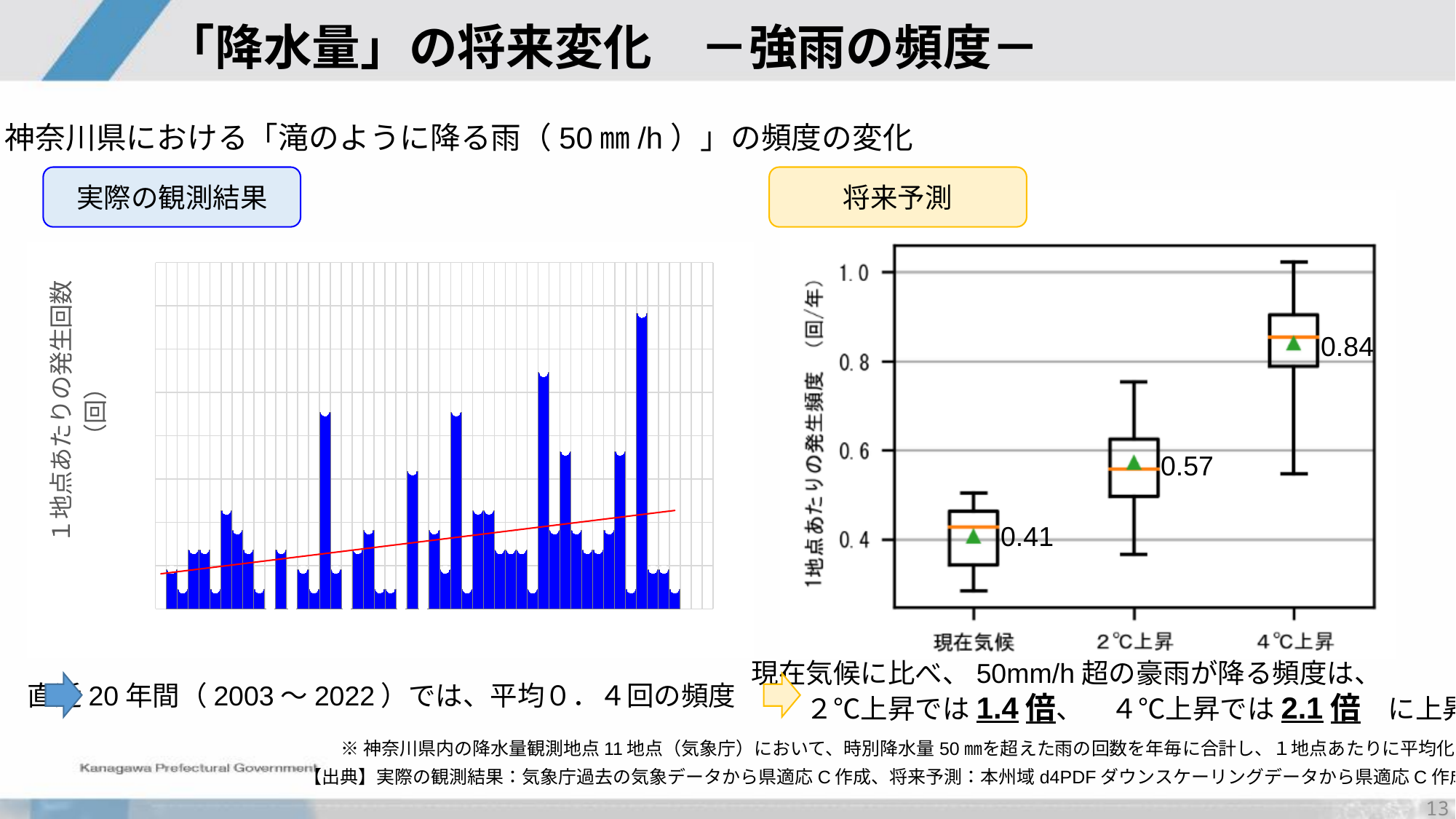
In the 将来予測 chart on the right, is the labelled value for 現在気候 greater or less than 0.6? less In the 将来予測 chart on the right, which is larger, the labelled value for 2℃上昇 or for 4℃上昇? 4℃上昇 How many categories are shown on the x axis of the 将来予測 chart on the right? 3 In the 将来予測 chart on the right, what is the labelled value for 現在気候? 0.41 In the 将来予測 chart on the right, what is the difference between the labelled values for 2℃上昇 and 現在気候? 0.16 In the 将来予測 chart on the right, do the labelled values rise or fall from 現在気候 to 4℃上昇? rise In the 将来予測 chart on the right, what is the labelled value for 2℃上昇? 0.57 In the 将来予測 chart on the right, which category has the highest labelled value? 4℃上昇 In the 将来予測 chart on the right, what is the difference between the labelled values for 4℃上昇 and 現在気候? 0.43 In the 将来予測 chart on the right, what is the labelled value for 4℃上昇? 0.84 In the 将来予測 chart on the right, which category has the lowest labelled value? 現在気候 What kind of chart is the 実際の観測結果 chart on the left? bar chart